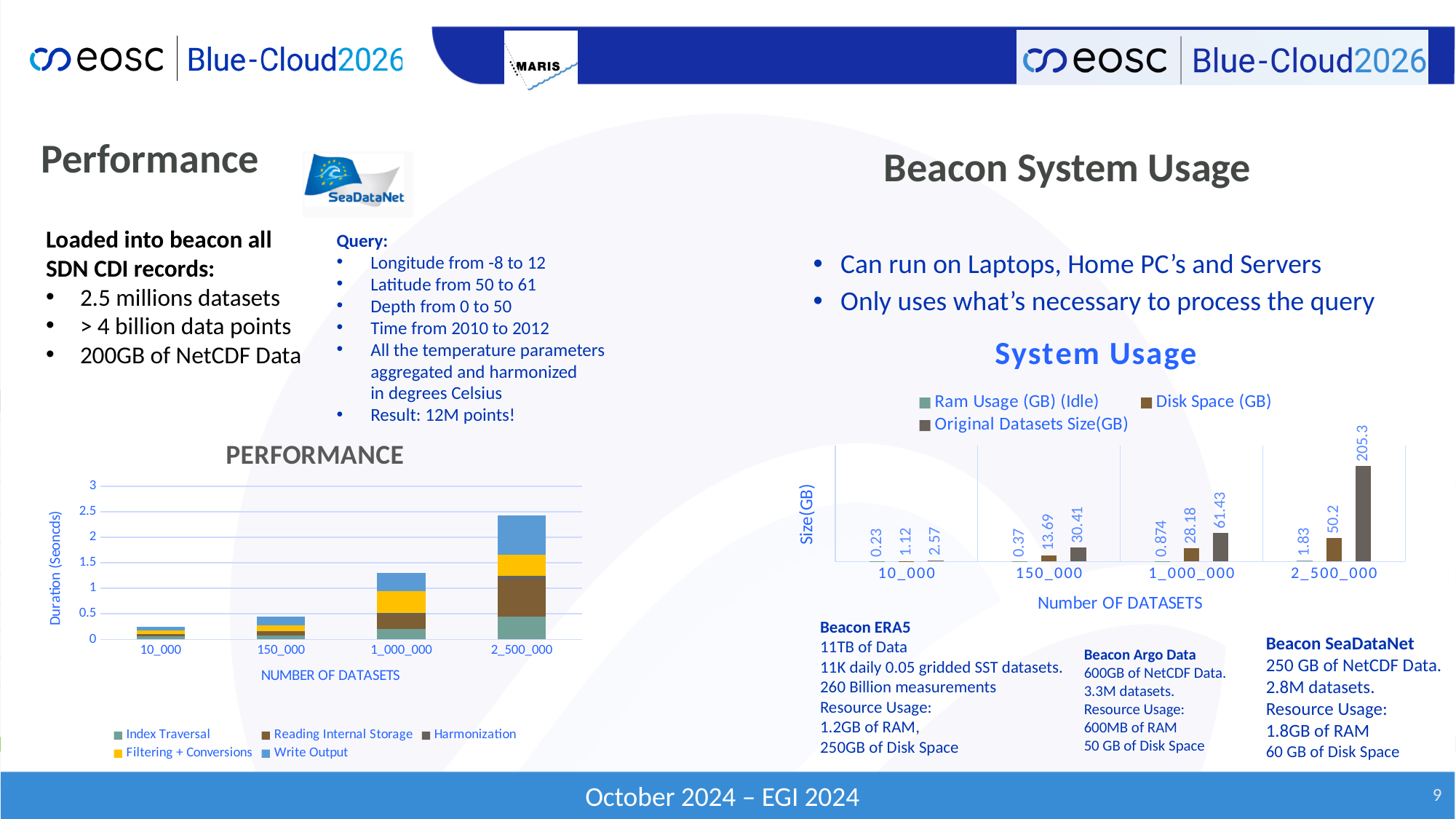
In the System Usage chart, what is the Ram Usage (GB) (Idle) for 1_000_000 datasets? 0.874 What kind of chart is the PERFORMANCE chart? Stacked bar chart In the PERFORMANCE chart, how many series does the legend list? 5 In the PERFORMANCE chart, is the total duration for 2_500_000 datasets greater or less than 2? greater In the System Usage chart, what is the Disk Space (GB) for 150_000 datasets? 13.69 In the System Usage chart, what is the Original Datasets Size (GB) for 2_500_000 datasets? 205.3 In the System Usage chart, which is larger for 150_000 datasets: Disk Space (GB) or Original Datasets Size (GB)? Original Datasets Size (GB) How many series does the legend of the System Usage chart list? 3 In the System Usage chart, which number of datasets has the highest Disk Space (GB)? 2_500_000 In the System Usage chart, which number of datasets has the lowest Ram Usage (GB) (Idle)? 10_000 In the System Usage chart, what is the difference between Original Datasets Size (GB) and Disk Space (GB) for 1_000_000 datasets? 33.25 In the PERFORMANCE chart, does the total duration rise or fall as the number of datasets increases along the x axis? rise